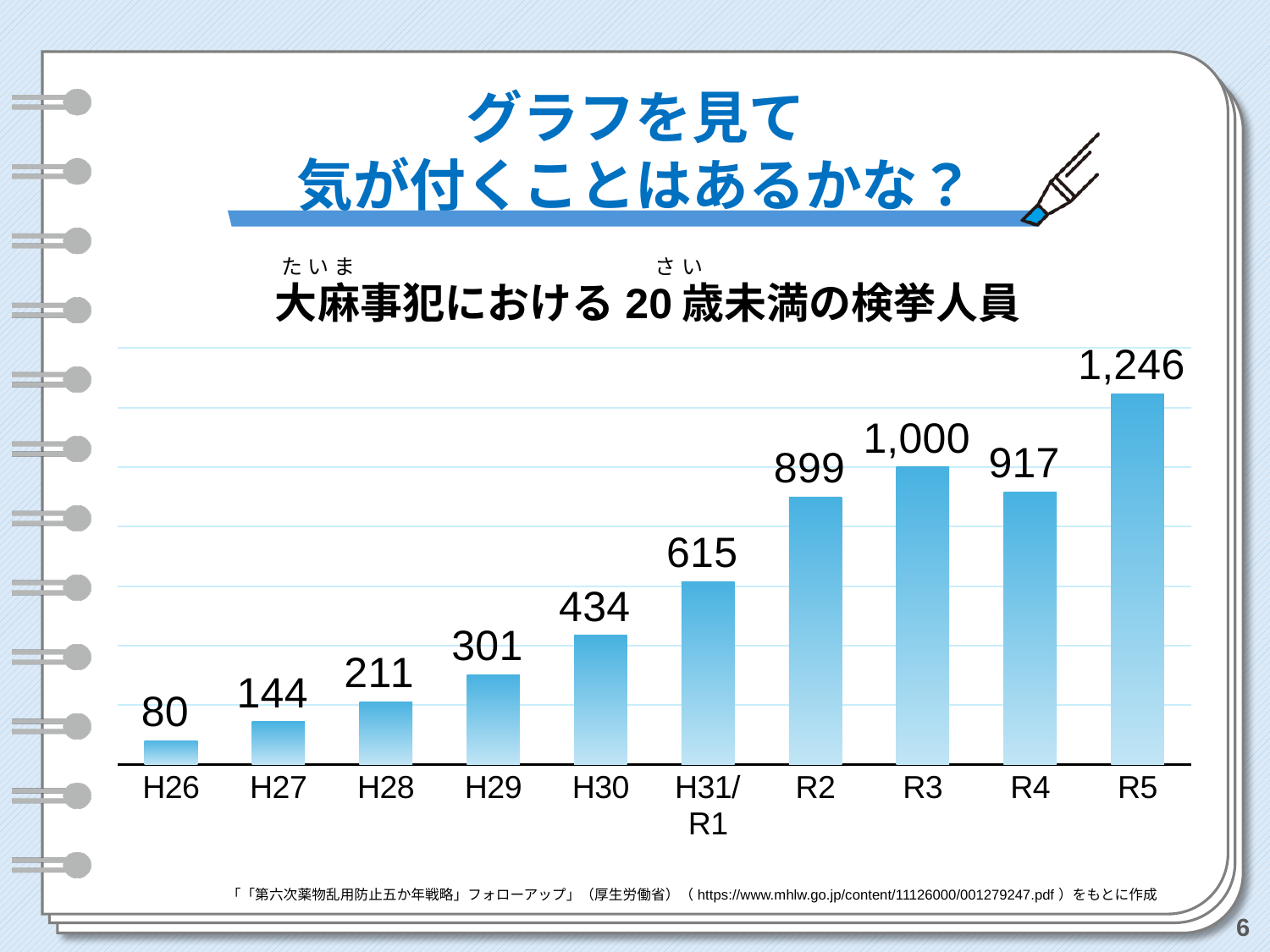
What is the difference between the values for R5 and R4? 329 Which is larger, the value for R2 or the value for R4? R4 What is the title of the chart? 大麻事犯における20歳未満の検挙人員 Which year has the lowest value? H26 Do the values generally rise or fall from H26 to R5? Rise What kind of chart is this? Bar chart What is the value for H26? 80 How many years (categories) are shown on the x axis? 10 What is the difference between the values for H30 and H29? 133 Which year has the highest value? R5 What is the value for R3? 1,000 What is the value for H31/R1? 615